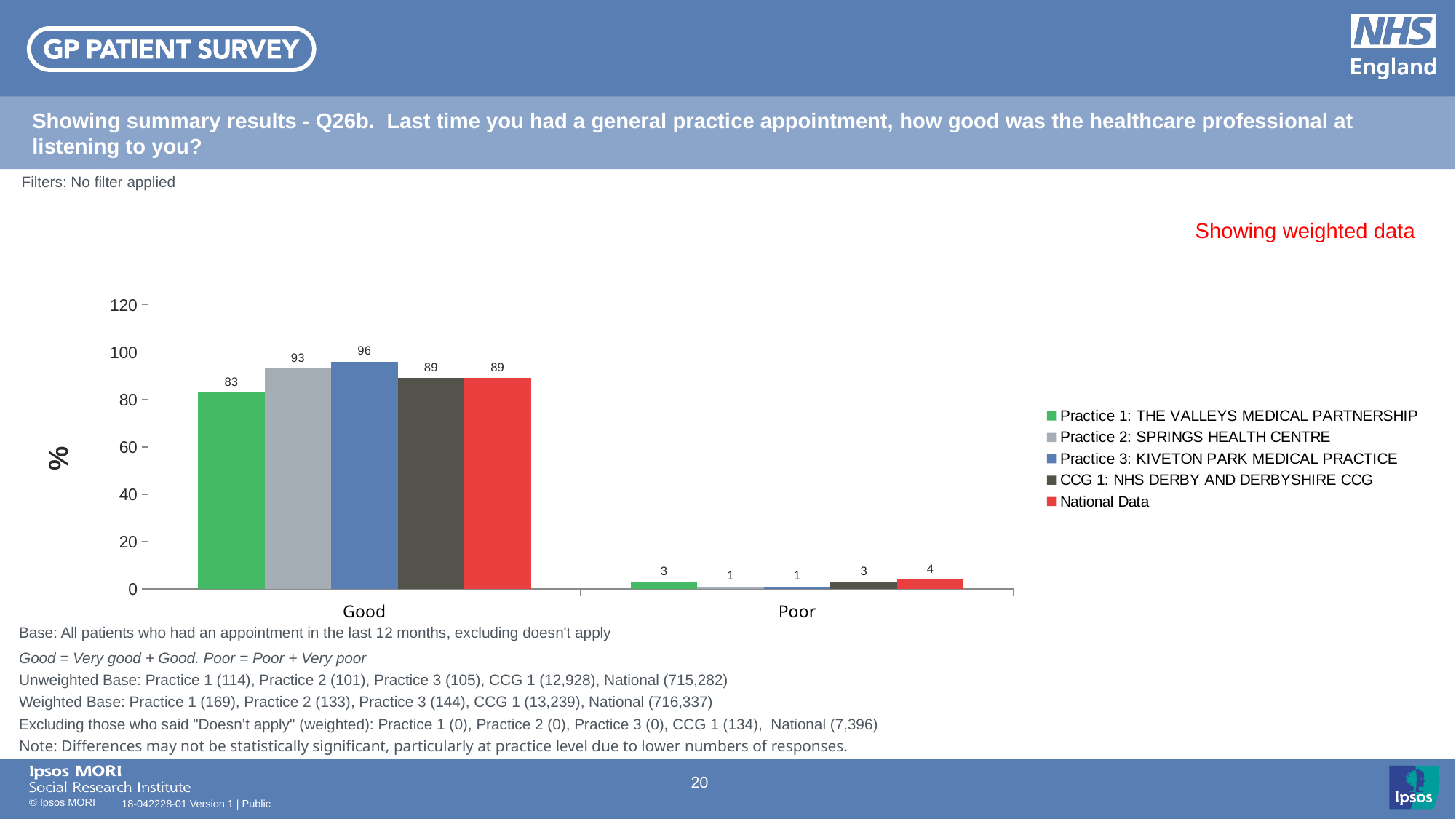
What is the value for Practice 1: THE VALLEYS MEDICAL PARTNERSHIP in the Good category? 83 What colour represents National Data in the chart? Red What is the value for CCG 1: NHS DERBY AND DERBYSHIRE CCG in the Good category? 89 What is the value for Practice 3: KIVETON PARK MEDICAL PRACTICE in the Good category? 96 Which is larger in the Good category: Practice 2: SPRINGS HEALTH CENTRE or National Data? Practice 2: SPRINGS HEALTH CENTRE How many categories are shown on the x axis? 2 Which series has the highest value in the Good category? Practice 3: KIVETON PARK MEDICAL PRACTICE What is the difference between the Good values for Practice 3: KIVETON PARK MEDICAL PRACTICE and Practice 1: THE VALLEYS MEDICAL PARTNERSHIP? 13 How many series does the legend list? 5 What kind of chart is shown on the slide? Bar chart Which series has the lowest value in the Good category? Practice 1: THE VALLEYS MEDICAL PARTNERSHIP What is the value for National Data in the Poor category? 4